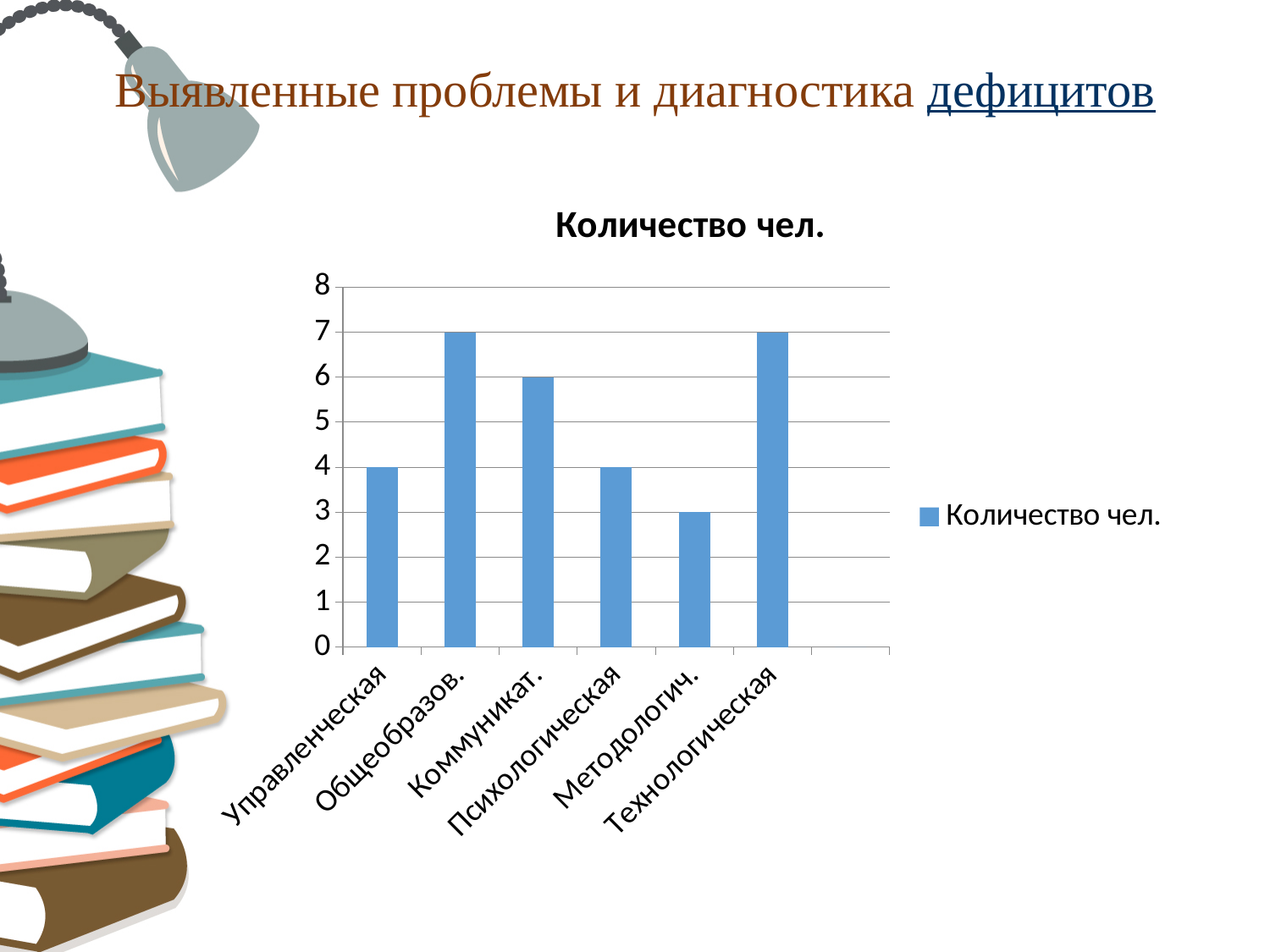
What is the value for Методологич.? 3 Which is larger, the value for Коммуникат. or the value for Управленческая? Коммуникат. What is the value for Коммуникат.? 6 What type of chart is shown on the slide? Bar chart What is the difference between the values for Технологическая and Психологическая? 3 What is the value for Управленческая? 4 How many series does the legend list? 1 What is the title of the chart? Количество чел. How many categories are shown on the x axis of the chart? 6 Which category has the lowest value? Методологич. What is the value for Общеобразов.? 7 Is the value for Технологическая greater or less than 5? greater